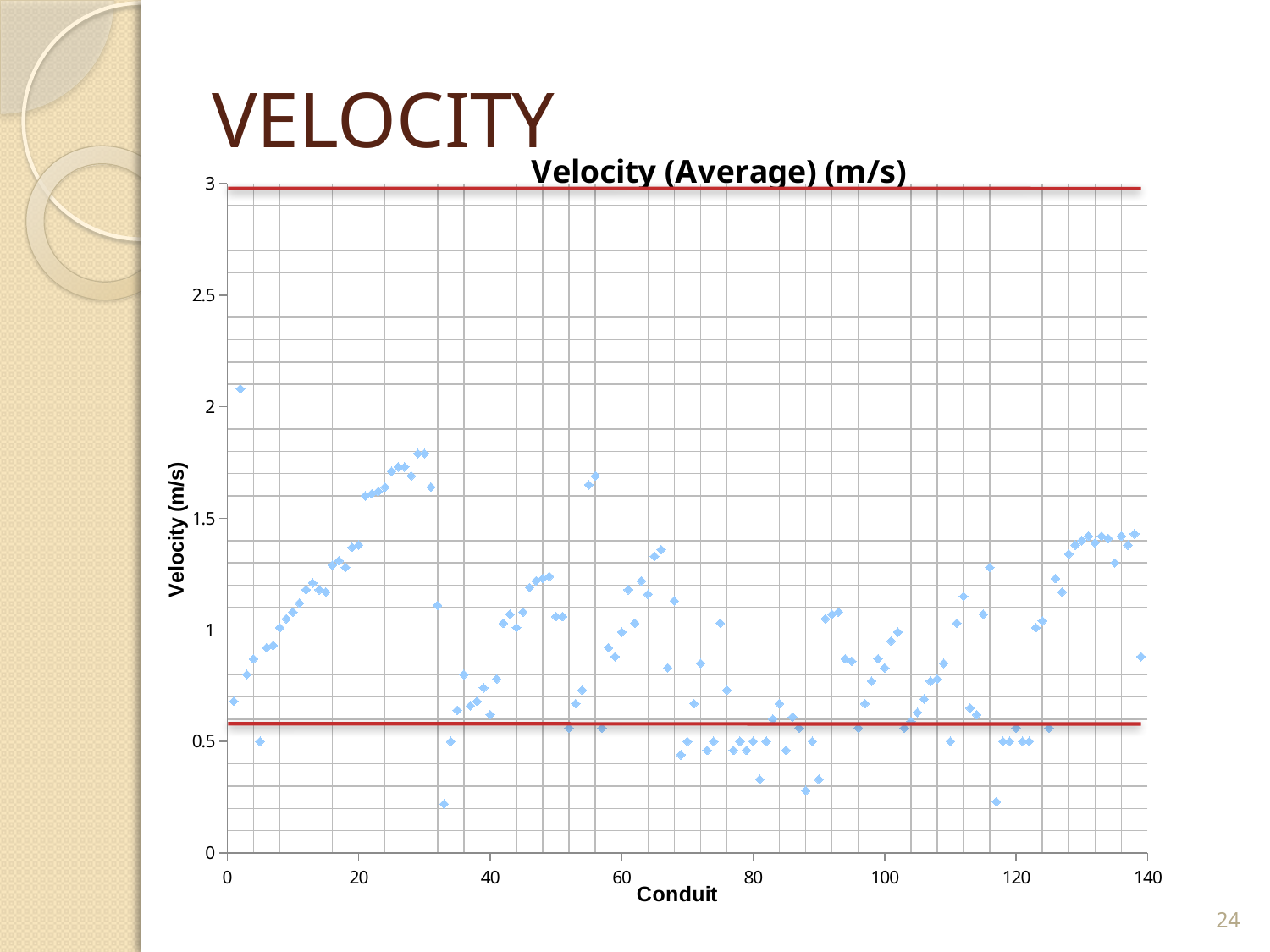
What is the title of the chart? Velocity (Average) (m/s) Is the highest plotted velocity value greater or less than 2.5? less What is the maximum value shown on the y axis? 3 What is the maximum value shown on the x axis? 140 What kind of chart is shown on the slide? Scatter chart Are any plotted points above the upper red horizontal line near 3 m/s? No Is the lowest plotted velocity value greater or less than 0.5? less